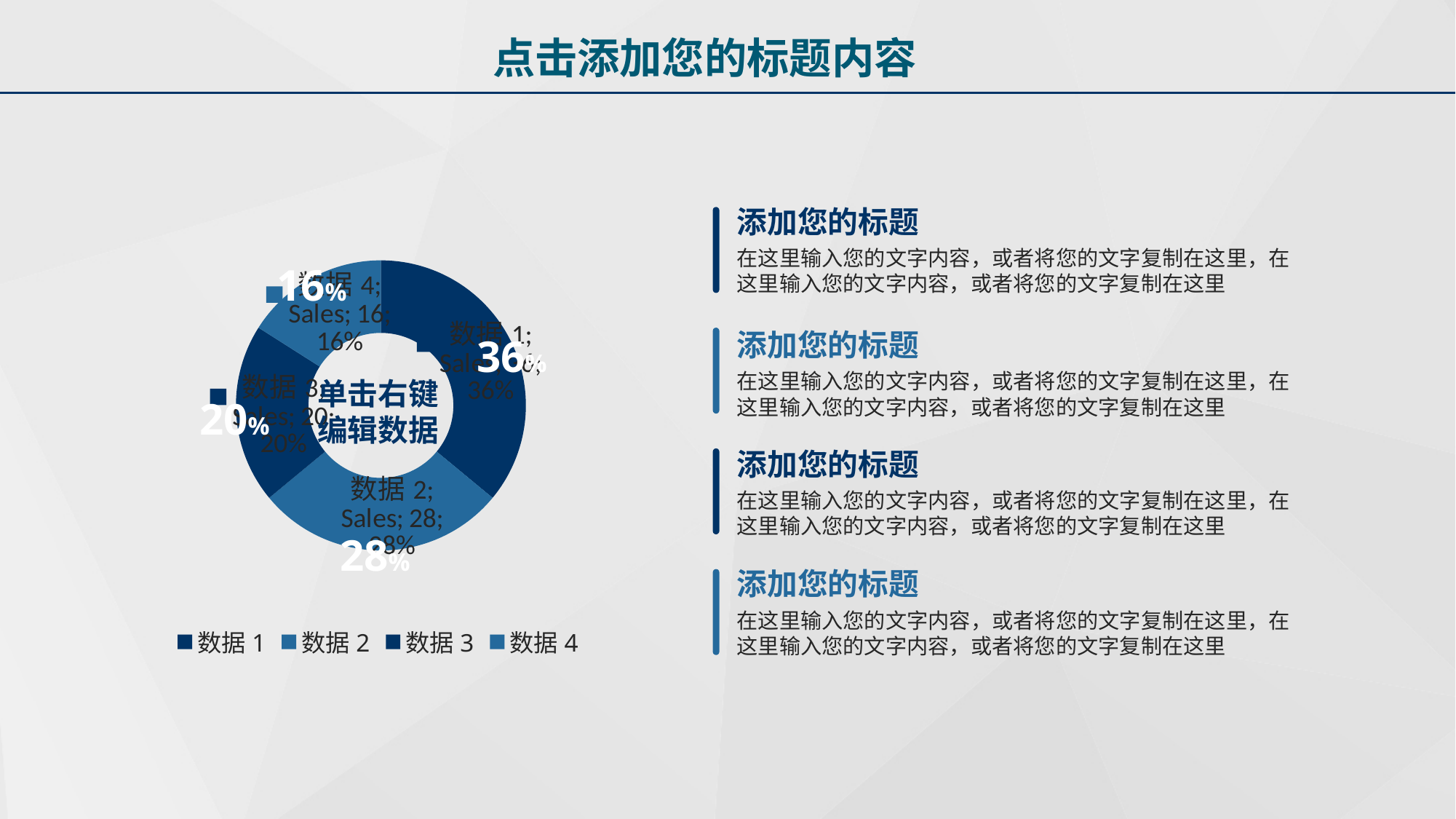
Which category has the smallest slice in the doughnut chart? 数据 4 Which category has the largest slice in the doughnut chart? 数据 1 How many categories does the doughnut chart have? 4 What percentage share does 数据 4 have in the doughnut chart? 16% What percentage share does 数据 3 have in the doughnut chart? 20% What text is shown in the centre of the doughnut chart? 单击右键编辑数据 Which has a larger share, 数据 2 or 数据 3? 数据 2 What percentage share does 数据 2 have in the doughnut chart? 28% What is the Sales value for 数据 2 in the doughnut chart? 28 What kind of chart is shown on the slide? Doughnut chart What is the difference in percentage points between the shares of 数据 1 and 数据 4? 20